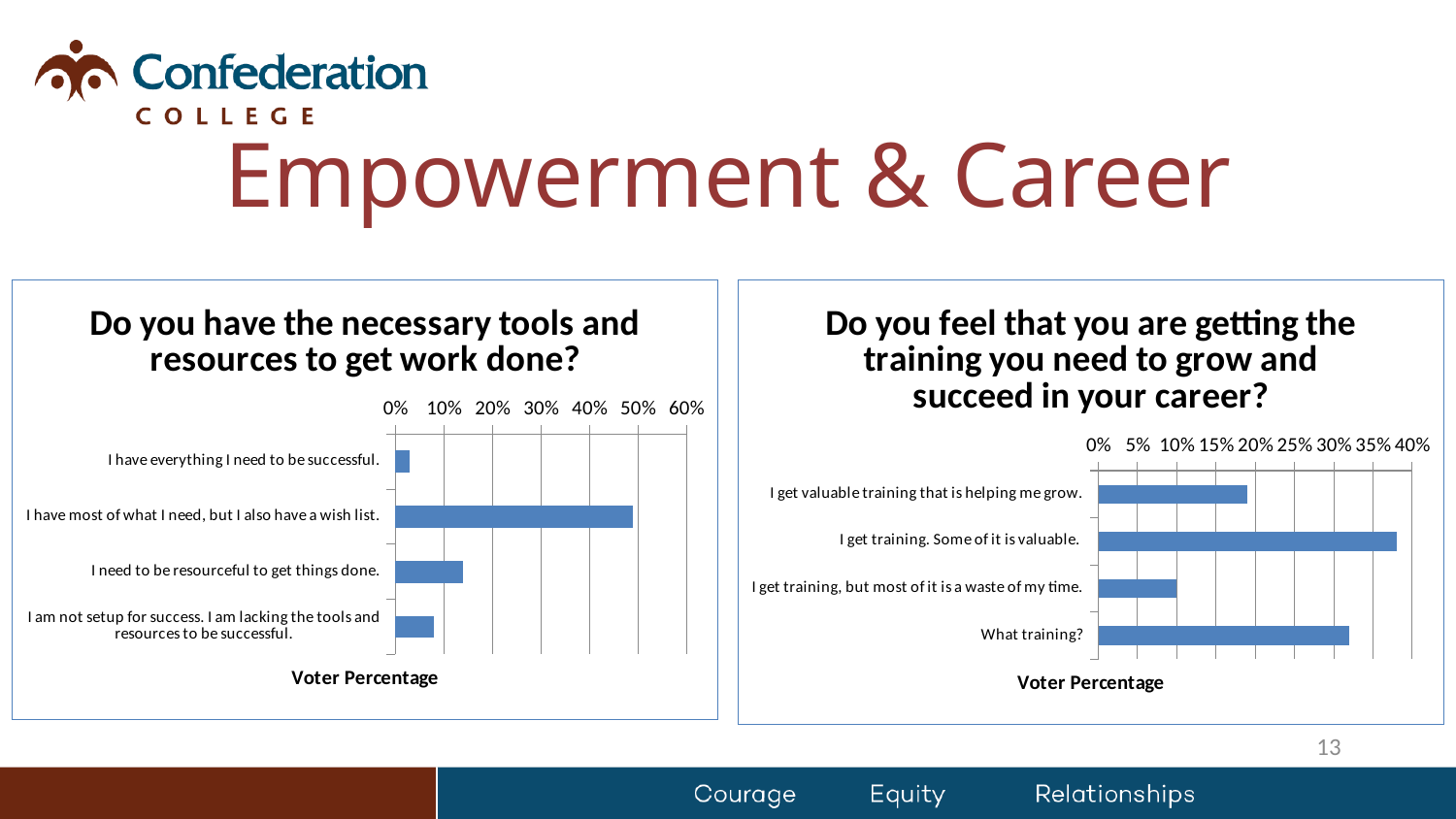
On the chart 'Do you have the necessary tools and resources to get work done?', is the value for 'I have most of what I need, but I also have a wish list.' greater or less than 40%? greater On the chart 'Do you feel that you are getting the training you need to grow and succeed in your career?', which category has the highest voter percentage? I get training. Some of it is valuable. How many categories are shown on the chart 'Do you have the necessary tools and resources to get work done?'? 4 On the chart 'Do you feel that you are getting the training you need to grow and succeed in your career?', which is larger: 'I get valuable training that is helping me grow.' or 'What training?'? What training? What is the x-axis label on the chart 'Do you feel that you are getting the training you need to grow and succeed in your career?'? Voter Percentage On the chart 'Do you feel that you are getting the training you need to grow and succeed in your career?', is the value for 'What training?' greater or less than 30%? greater On the chart 'Do you have the necessary tools and resources to get work done?', which is larger: 'I need to be resourceful to get things done.' or 'I am not setup for success. I am lacking the tools and resources to be successful.'? I need to be resourceful to get things done. On the chart 'Do you feel that you are getting the training you need to grow and succeed in your career?', which category has the lowest voter percentage? I get training, but most of it is a waste of my time. On the chart 'Do you have the necessary tools and resources to get work done?', which category has the highest voter percentage? I have most of what I need, but I also have a wish list. What kind of chart is 'Do you feel that you are getting the training you need to grow and succeed in your career?'? Bar chart On the chart 'Do you have the necessary tools and resources to get work done?', is the value for 'I have everything I need to be successful.' greater or less than 10%? less On the chart 'Do you have the necessary tools and resources to get work done?', which category has the lowest voter percentage? I have everything I need to be successful.